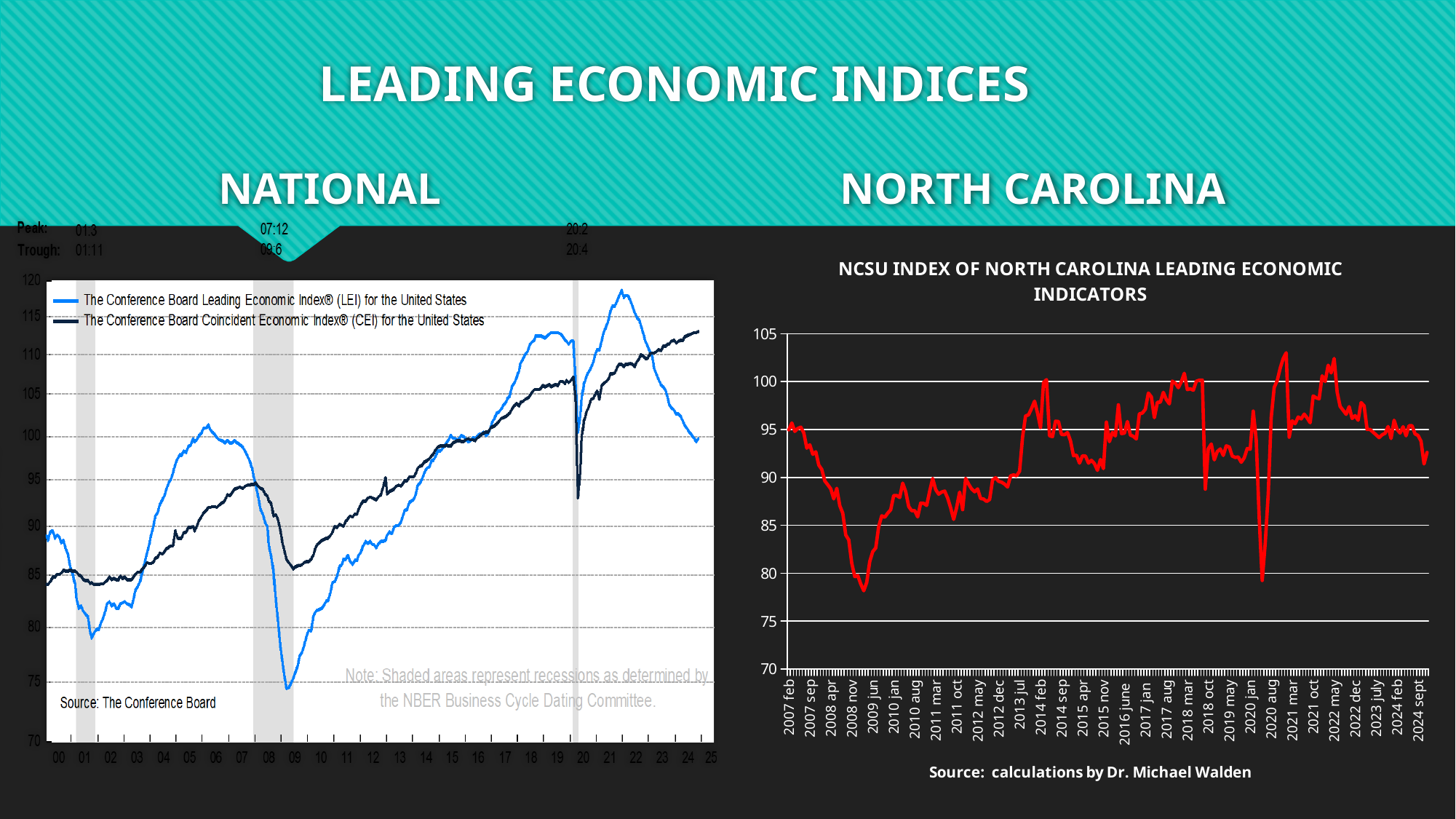
What kind of chart is the NATIONAL chart on the left? line chart In the NATIONAL chart, is the CEI value in 2024 greater or less than 110? greater In the NATIONAL chart, is the LEI value in 2009 greater or less than 80? less In the NORTH CAROLINA chart, is the value at 2009 jun greater or less than 80? greater What kind of chart is the NORTH CAROLINA chart on the right? line chart What is the title of the NORTH CAROLINA chart? NCSU INDEX OF NORTH CAROLINA LEADING ECONOMIC INDICATORS In the NORTH CAROLINA chart, in which year does the index reach its lowest point? 2009 In the NORTH CAROLINA chart, does the index rise or fall between 2022 may and 2024 sept? fall How many series does the legend of the NATIONAL chart list? 2 In the NATIONAL chart, which series is drawn in the lighter blue line? The Conference Board Leading Economic Index® (LEI) for the United States